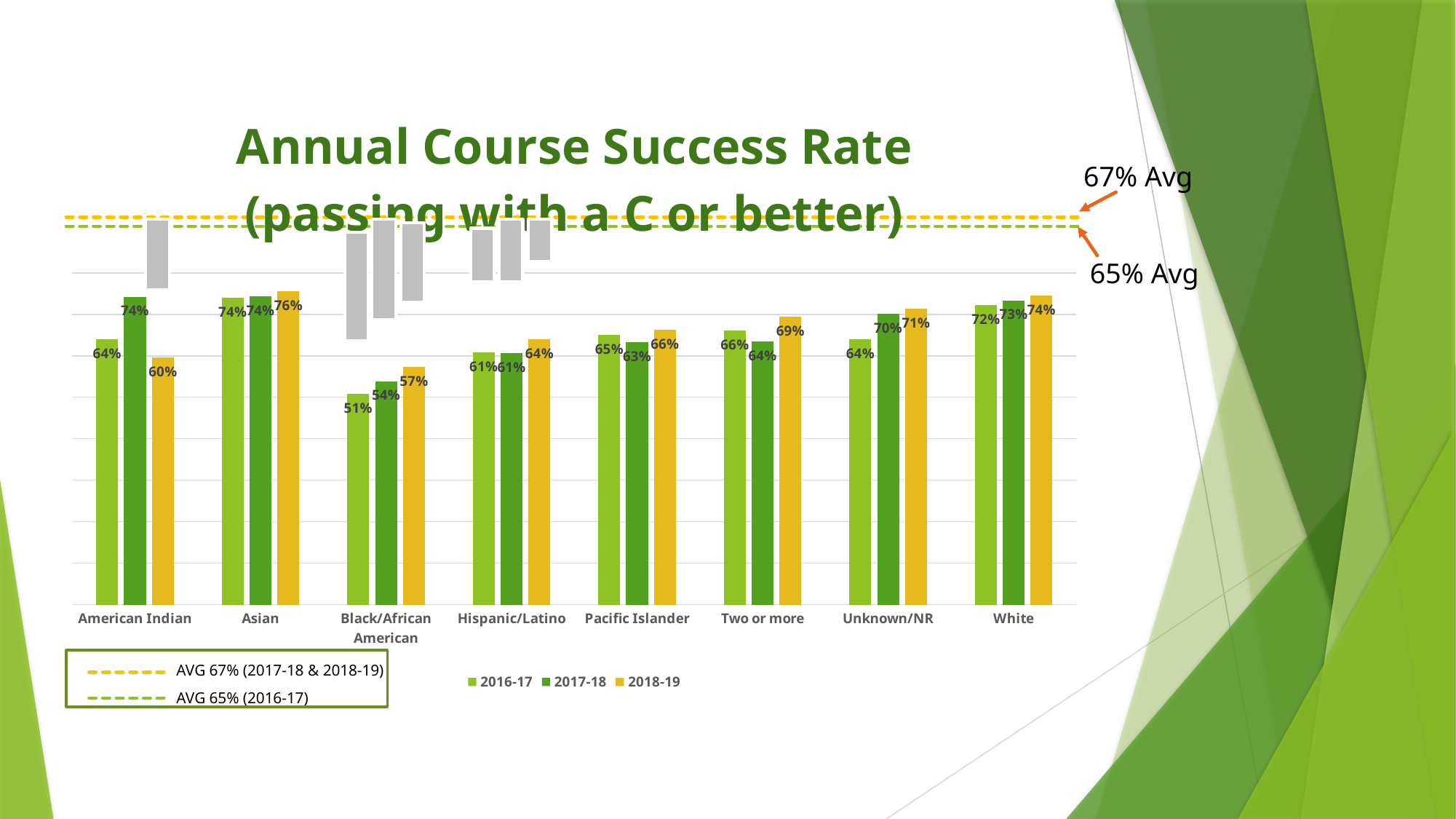
Did the course success rate for Black/African American students rise or fall from 2016-17 to 2018-19? Rise Which group has the lowest 2016-17 course success rate? Black/African American How many academic years does the legend list? 3 What is the 2018-19 course success rate for Asian students? 76% How many student groups are shown on the x axis? 8 By how many percentage points did the American Indian success rate fall from 2017-18 to 2018-19? 14 percentage points What is the 2017-18 course success rate for Pacific Islander students? 63% What does the yellow dashed horizontal line represent according to the legend box? AVG 67% (2017-18 & 2018-19) Which group has the highest 2018-19 course success rate? Asian What type of chart is shown on the slide? Bar chart Which is higher in 2017-18: the success rate for Unknown/NR or for Two or more? Unknown/NR What is the 2016-17 course success rate for Black/African American students? 51%